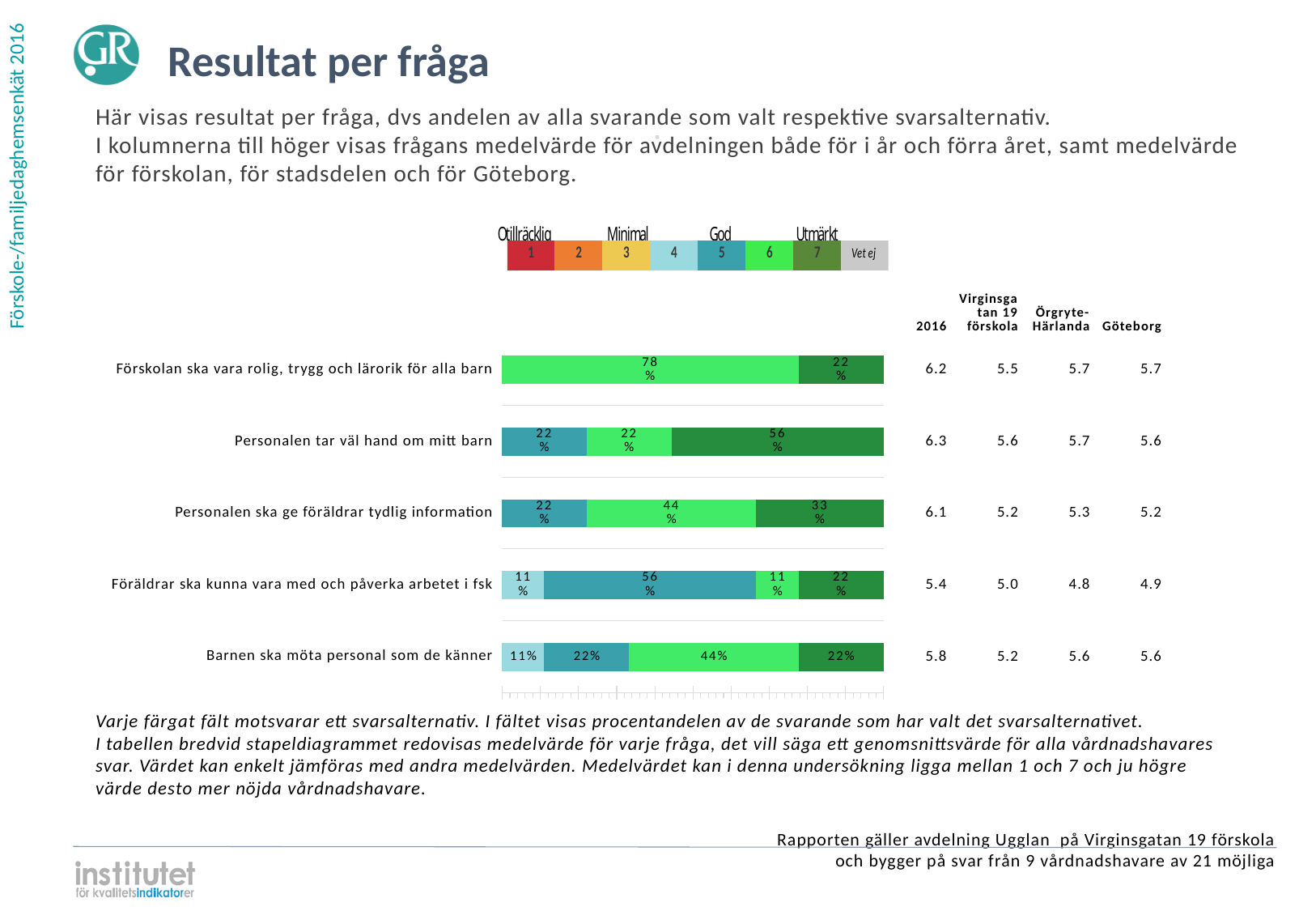
What percentage of respondents chose answer 6 (light green) for 'Förskolan ska vara rolig, trygg och lärorik för alla barn'? 78% What is the total of the two segments in the bar for 'Förskolan ska vara rolig, trygg och lärorik för alla barn'? 100% For 'Barnen ska möta personal som de känner', which is larger: the share for answer 5 or the share for answer 6? Answer 6 What is the 2016 mean value shown for 'Personalen tar väl hand om mitt barn'? 6.3 What is the difference between the answer-6 share (44%) and the answer-7 share (33%) for 'Personalen ska ge föräldrar tydlig information'? 11% How many answer alternatives, including 'Vet ej', does the colour legend above the chart show? 8 What kind of chart is shown on the slide? Stacked bar chart What percentage chose answer 6 (light green) for 'Barnen ska möta personal som de känner'? 44% What percentage chose answer 5 (teal) for 'Föräldrar ska kunna vara med och påverka arbetet i fsk'? 56% How many questions (categories) are plotted in the bar chart? 5 What percentage chose answer 7 (dark green) for 'Personalen tar väl hand om mitt barn'? 56% Which question has the largest share of respondents choosing answer 7 (dark green)? Personalen tar väl hand om mitt barn